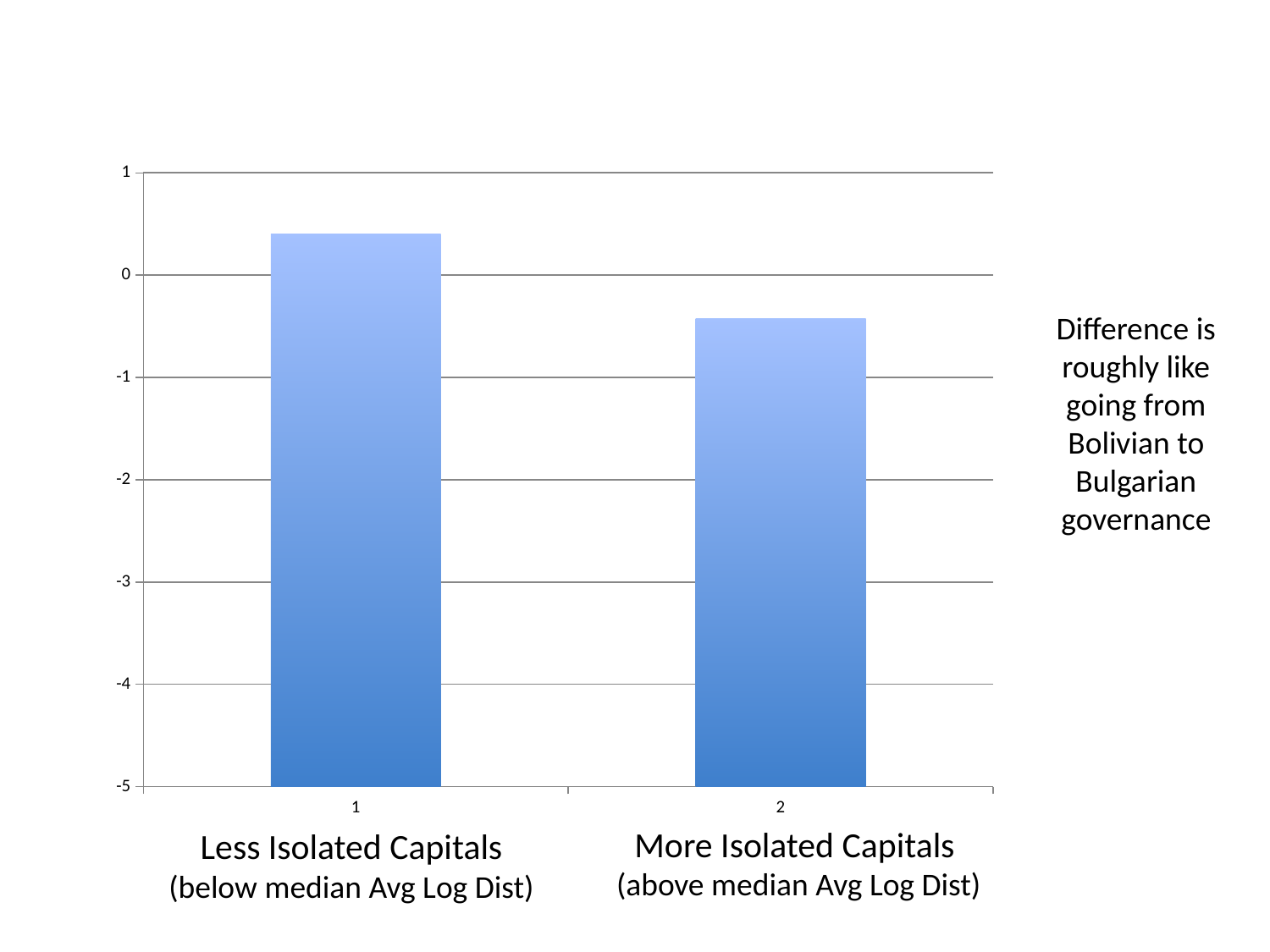
According to the text beside the chart, the difference is roughly like going from which governance to which? Bolivian to Bulgarian governance What kind of chart is shown on the slide? bar chart Which category has the lower value in the chart? More Isolated Capitals Is the value for Less Isolated Capitals larger or smaller than the value for More Isolated Capitals? larger Is the value for More Isolated Capitals greater or less than 0? less What is the lowest value shown on the vertical axis? -5 Is the value for Less Isolated Capitals greater or less than 1? less Is the value for Less Isolated Capitals greater or less than 0? greater Do the bar values rise or fall from category 1 to category 2? fall Which category has the higher value, Less Isolated Capitals or More Isolated Capitals? Less Isolated Capitals How many bars are plotted in the chart? 2